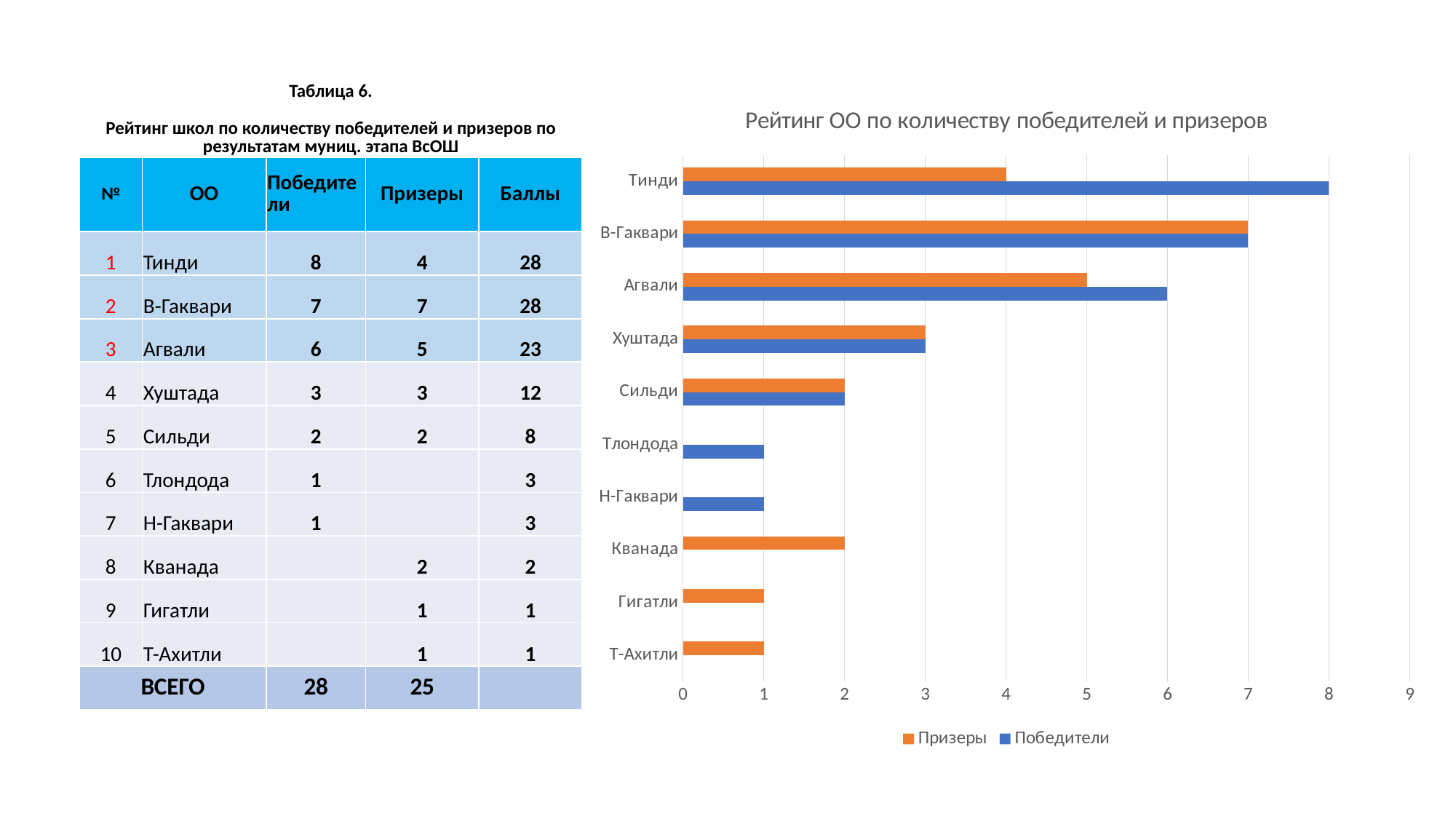
What is the value of Призеры for В-Гаквари on the chart? 7 Is the value of Победители for Агвали greater or less than 5? greater What is the difference between Победители and Призеры for Тинди on the chart? 4 Which school has the highest value for Победители on the chart? Тинди Which is larger for Агвали on the chart: Победители or Призеры? Победители How many series does the chart legend list? 2 Which colour represents Призеры in the chart legend? orange What is the value of Победители for Тинди on the chart? 8 How many schools (categories) are shown on the chart's vertical axis? 10 Which school has the highest value for Призеры on the chart? В-Гаквари What kind of chart is shown on the slide? bar chart What is the title of the chart? Рейтинг ОО по количеству победителей и призеров